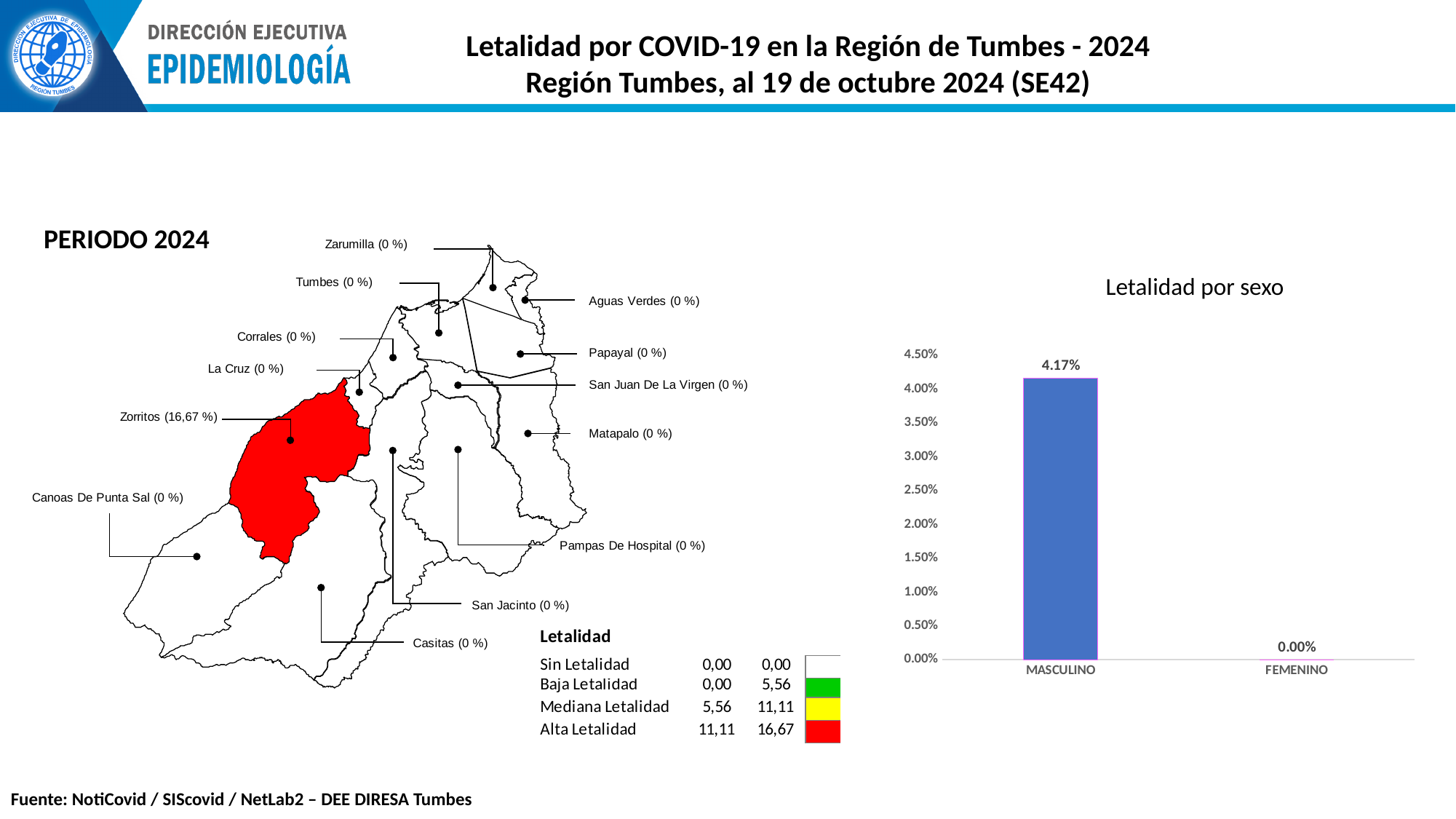
On the map, which district is shown with a lethality of 16,67 %? Zorritos In the 'Letalidad por sexo' chart, what is the value for FEMENINO? 0.00% In the 'Letalidad por sexo' chart, what is the value for MASCULINO? 4.17% In the 'Letalidad por sexo' chart, is the value for MASCULINO greater or less than 4.00%? greater What is the title of the chart on the right side of the slide? Letalidad por sexo In the 'Letalidad por sexo' chart, which category has the lowest value? FEMENINO What kind of chart is 'Letalidad por sexo'? bar chart In the 'Letalidad por sexo' chart, which category has the highest value? MASCULINO In the 'Letalidad por sexo' chart, what is the difference between the MASCULINO and FEMENINO values? 4.17% On the map, what is the lethality shown for Tumbes? 0 % In the 'Letalidad por sexo' chart, how many categories are shown on the x axis? 2 In the 'Letalidad por sexo' chart, what is the highest value shown on the y axis? 4.50%